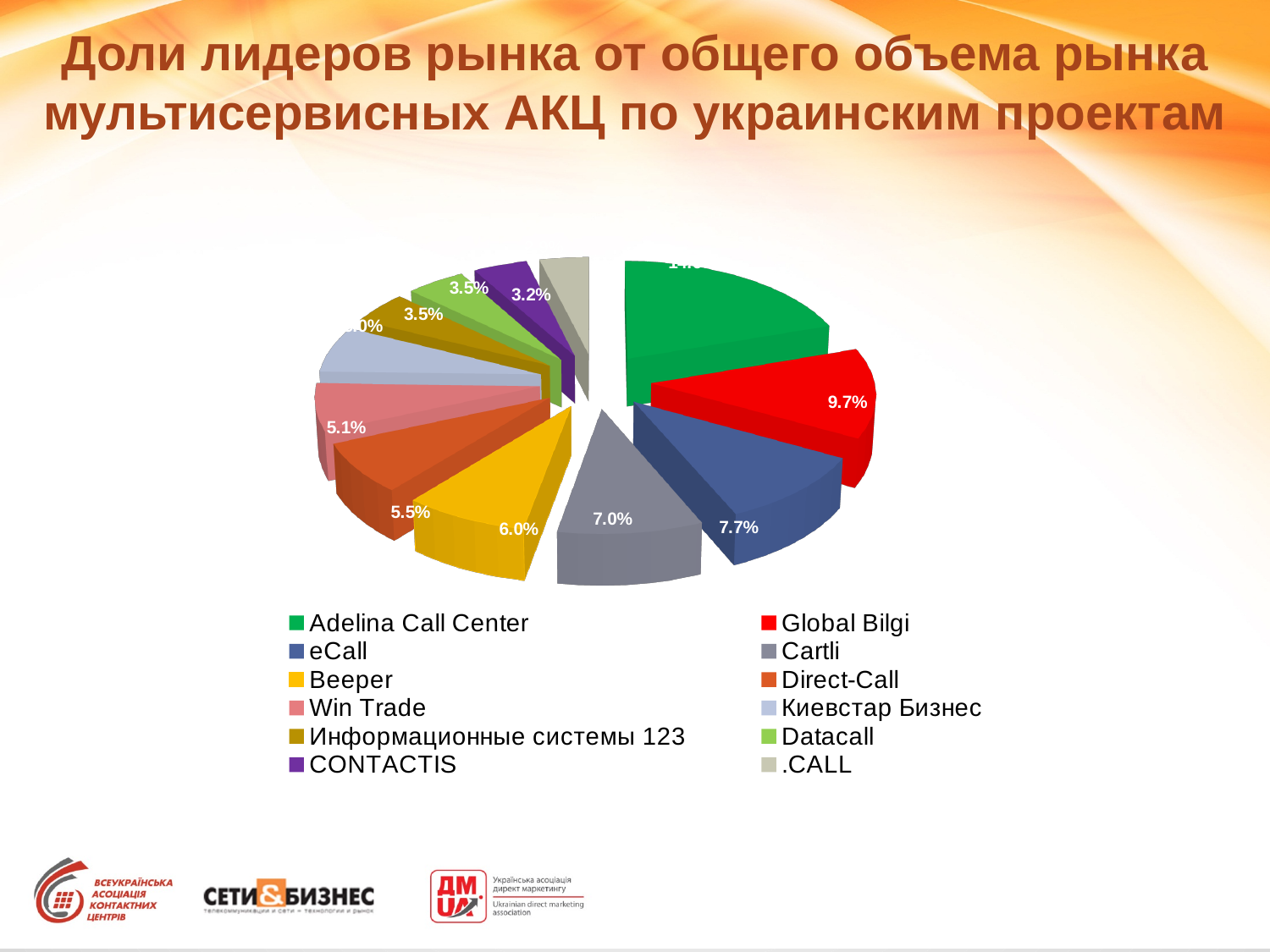
What percentage does Win Trade have in the pie chart? 5.1% Which company is represented by the red slice in the pie chart? Global Bilgi What kind of chart is shown on the slide? pie chart Which company has the largest slice of the pie chart? Adelina Call Center What is the value shown for eCall? 7.7% What is the difference between the shares of Global Bilgi and eCall? 2.0% Which is larger, the share of Global Bilgi or the share of eCall? Global Bilgi What percentage is labelled for Cartli? 7.0% What share is shown for Beeper? 6.0% What is the value for Direct-Call? 5.5% What share of the market does Global Bilgi hold according to the pie chart? 9.7% How many companies are listed in the legend of the pie chart? 12